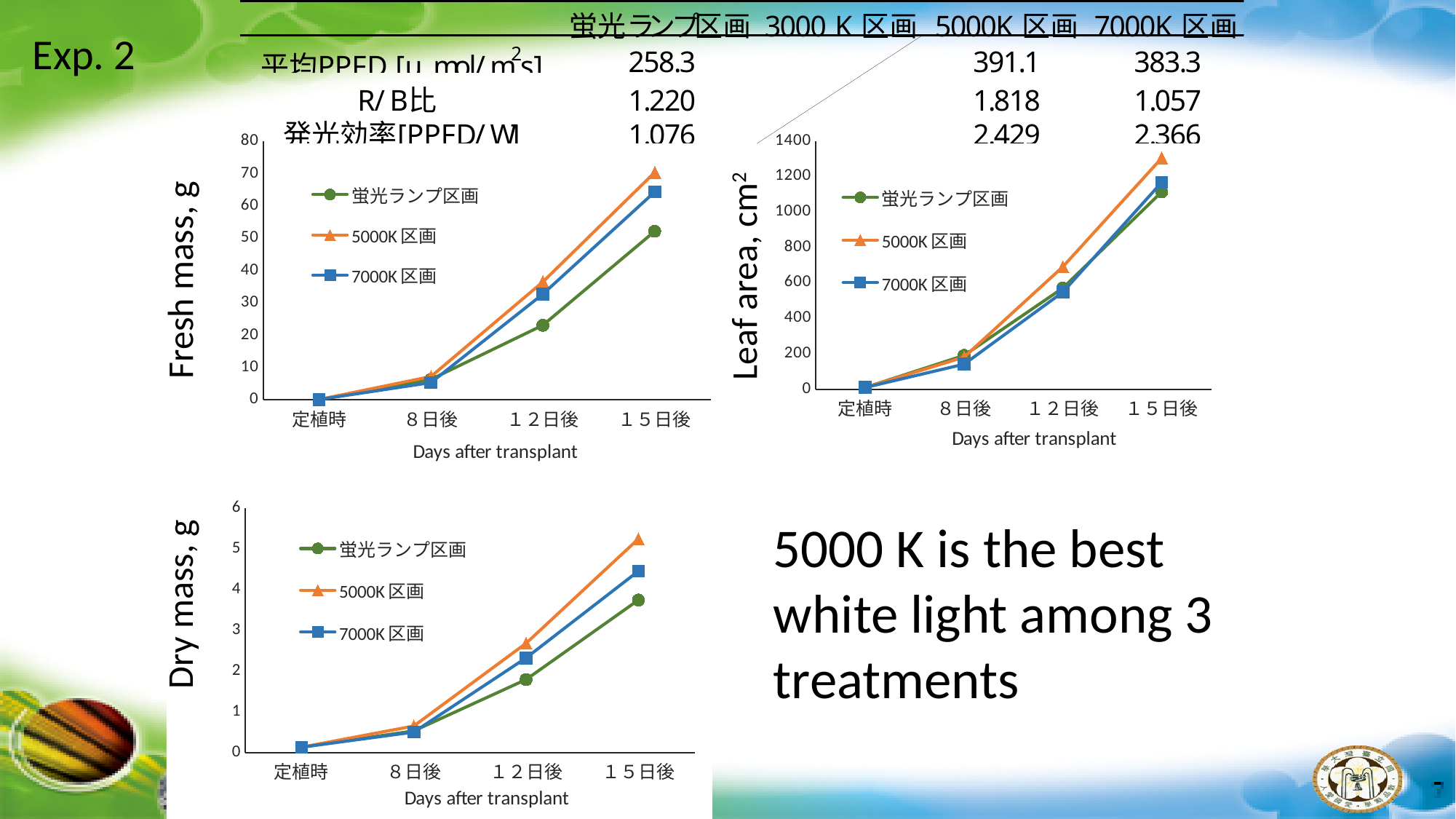
In the Dry mass chart, at 15日後, which is larger: 7000K 区画 or 蛍光ランプ区画? 7000K 区画 In the Leaf area chart, is the value for 7000K 区画 at 8日後 greater or less than 200? less What is the x-axis title of the Leaf area chart? Days after transplant In the Dry mass chart, is the value for 蛍光ランプ区画 at 15日後 greater or less than 4? less In the Fresh mass chart, do the values for 5000K 区画 rise or fall from 定植時 to 15日後? rise In the Leaf area chart, is the value for 5000K 区画 at 15日後 greater or less than 1200? greater In the Fresh mass chart, which series is lowest at 15日後? 蛍光ランプ区画 What kind of chart is the Fresh mass chart? line chart How many series does the legend of the Leaf area chart list? 3 In the Fresh mass chart, which series is highest at 15日後? 5000K 区画 How many x-axis categories does the Dry mass chart have? 4